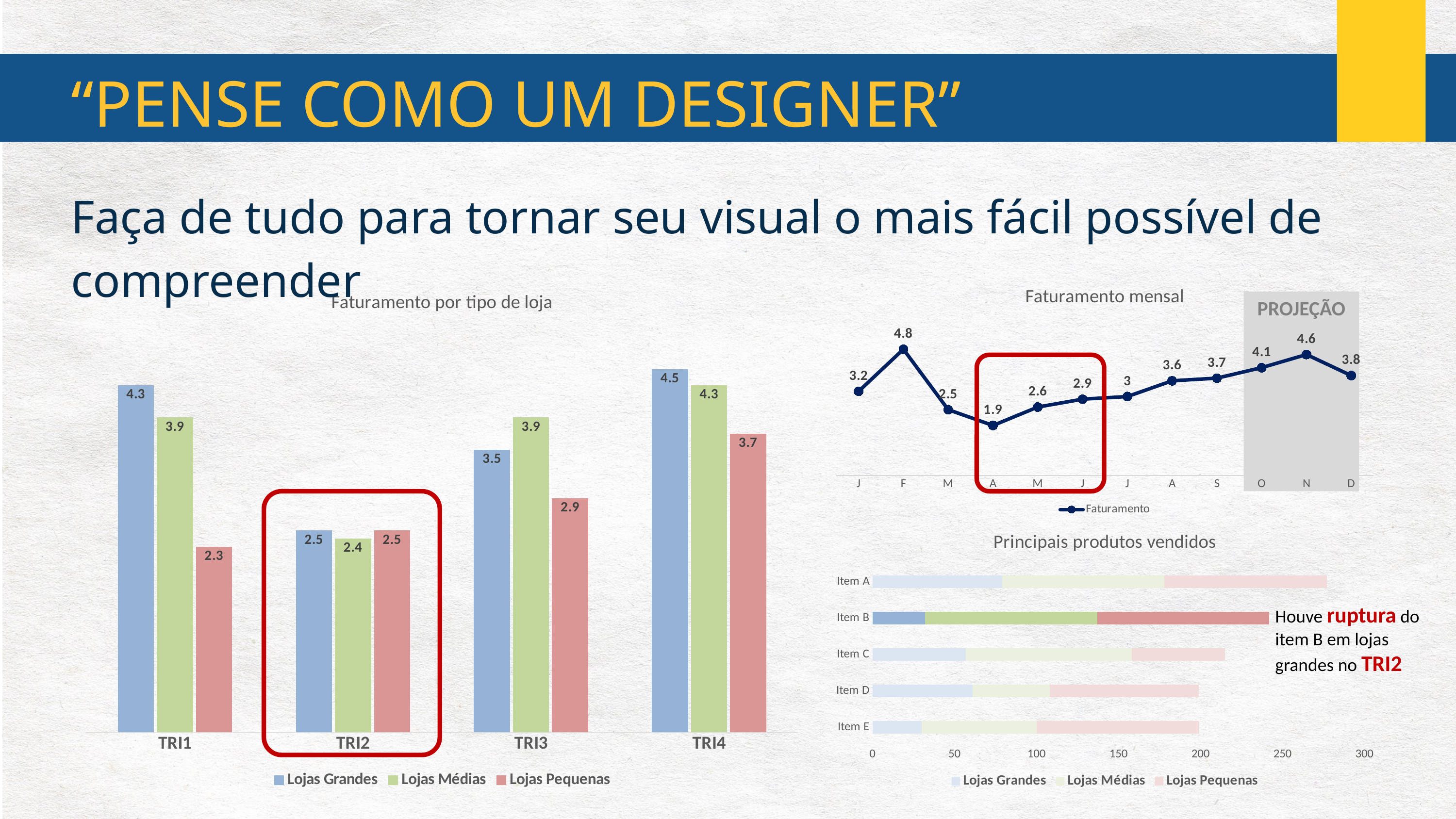
In the 'Principais produtos vendidos' chart, is the total for Item A greater or less than 250? greater In the 'Faturamento por tipo de loja' chart, how many series does the legend list? 3 In the 'Faturamento mensal' chart, do the values rise or fall from A to N? Rise In the 'Faturamento por tipo de loja' chart, what is the difference between Lojas Grandes and Lojas Pequenas in TRI1? 2.0 In the 'Faturamento mensal' chart, which month has the lowest value? A (1.9) In the 'Faturamento mensal' chart, how many data points are plotted? 12 In the 'Faturamento por tipo de loja' chart, what is the value for Lojas Grandes in TRI1? 4.3 In the 'Principais produtos vendidos' chart, how many items are listed? 5 In the 'Faturamento mensal' chart, what is the value for F? 4.8 In the 'Faturamento mensal' chart, what kind of chart is it? Line chart In the 'Faturamento por tipo de loja' chart, what is the value for Lojas Pequenas in TRI3? 2.9 In the 'Faturamento por tipo de loja' chart, which quarter has the highest value for Lojas Grandes? TRI4